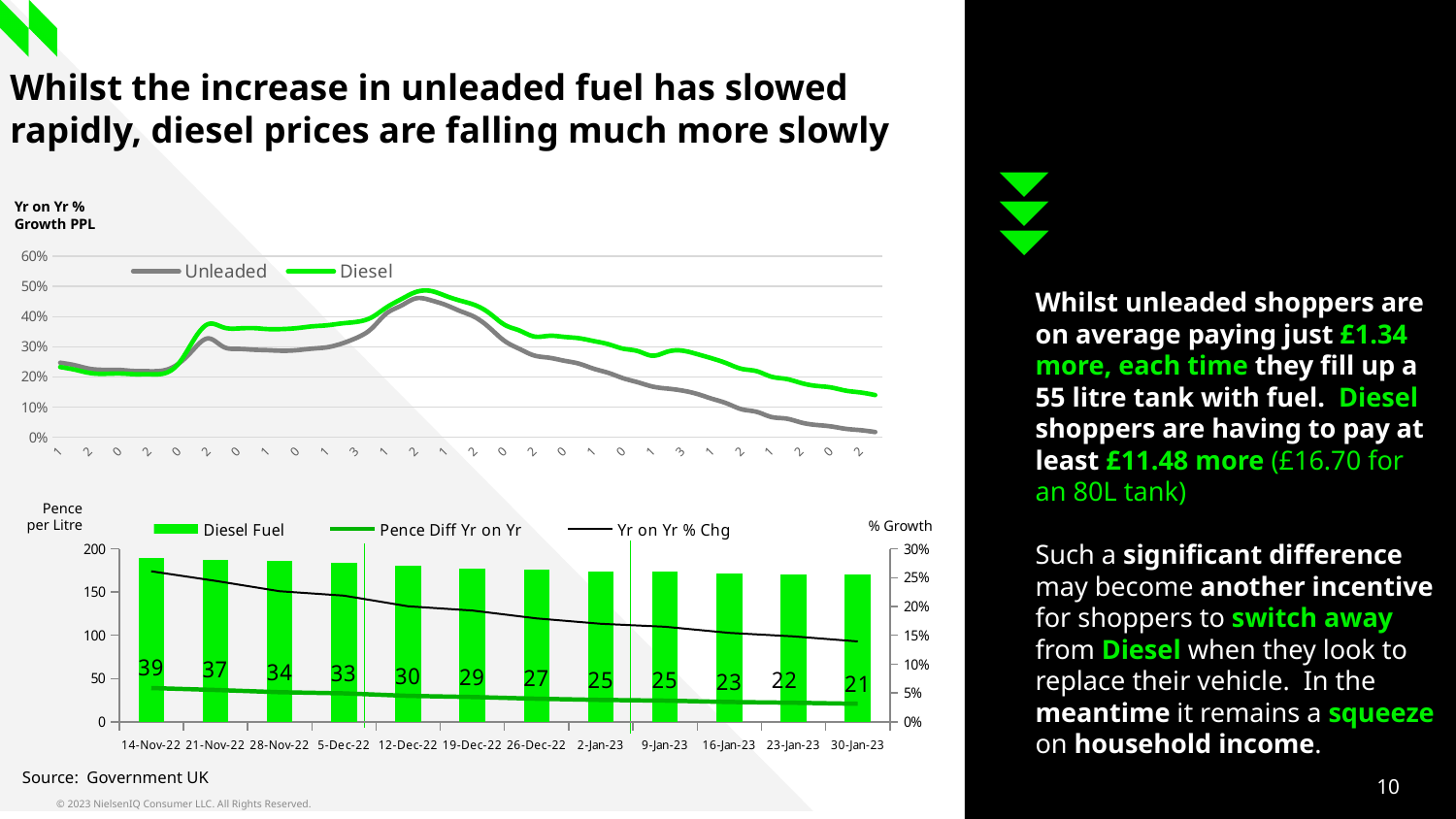
In the bottom chart, what is the Pence Diff Yr on Yr value for 14-Nov-22? 39 In the bottom chart, which date has the lowest Pence Diff Yr on Yr value? 30-Jan-23 What kind of chart is the top chart (Yr on Yr % Growth PPL)? line chart In the bottom chart, do the Pence Diff Yr on Yr values rise or fall from 14-Nov-22 to 30-Jan-23? fall In the top chart (Yr on Yr % Growth PPL), at the right-hand end of the x axis, which series is higher, Unleaded or Diesel? Diesel In the bottom chart, what is the Pence Diff Yr on Yr value for 26-Dec-22? 27 In the bottom chart, what is the difference between the Pence Diff Yr on Yr values for 14-Nov-22 and 30-Jan-23? 18 How many series does the legend of the top chart (Yr on Yr % Growth PPL) list? 2 In the bottom chart, which date has the highest Pence Diff Yr on Yr value? 14-Nov-22 How many series does the legend of the bottom chart list? 3 How many dates are shown on the x axis of the bottom chart? 12 In the bottom chart, what is the Pence Diff Yr on Yr value for 30-Jan-23? 21